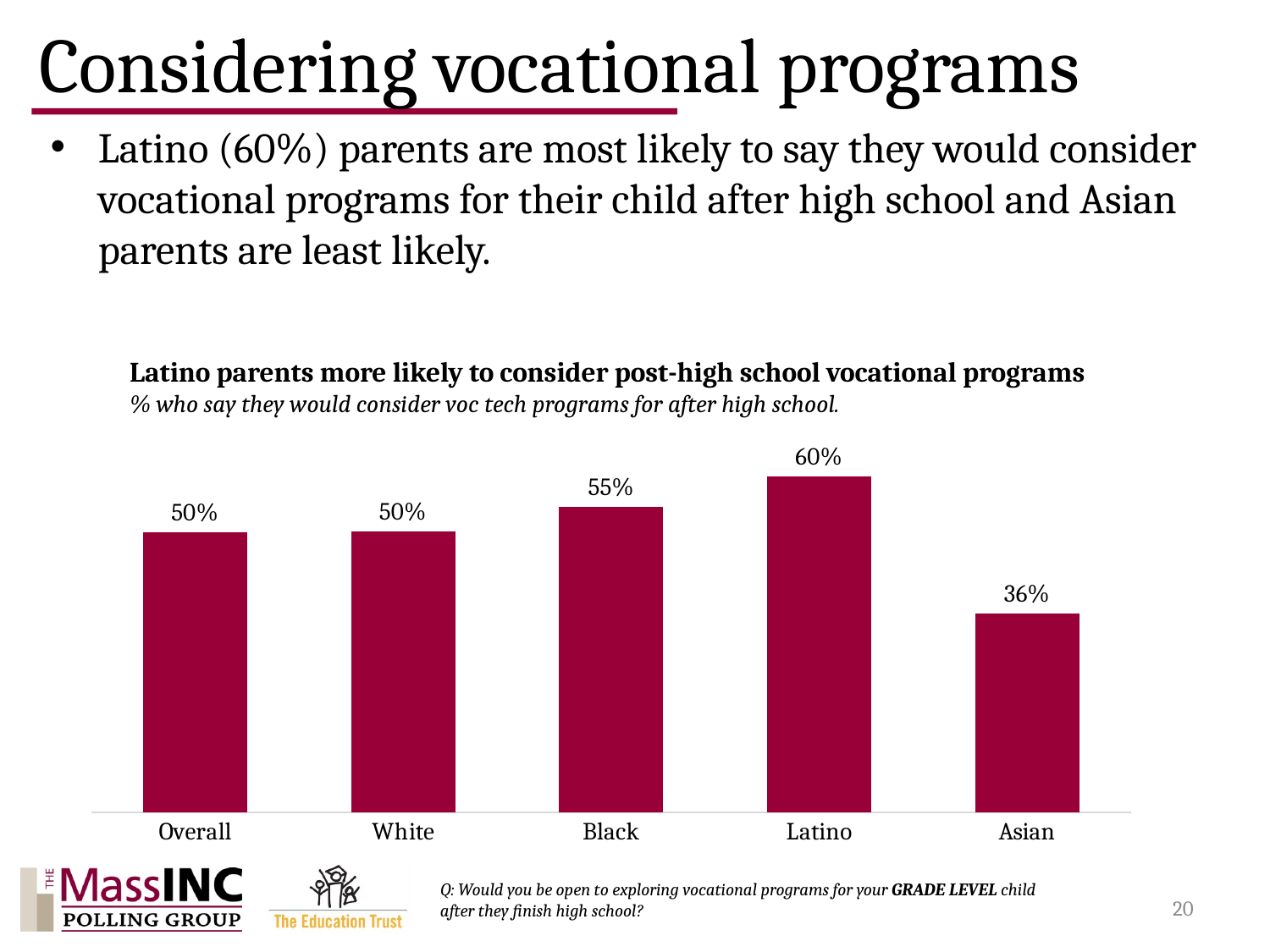
What is the difference between the Black and White values? 5 percentage points What is the difference between the Latino and Asian values? 24 percentage points Which group has the highest value in the chart? Latino What is the Overall value in the chart? 50% What percentage of Latino parents say they would consider voc tech programs for after high school? 60% Which group has the lowest value in the chart? Asian Which is larger, the value for Black parents or the value for White parents? Black How many groups are shown on the x axis of the chart? 5 What is the value shown for Asian parents? 36% What is the value shown for Black parents? 55% What type of chart is shown on the slide? Bar chart What is the title of the chart? Latino parents more likely to consider post-high school vocational programs